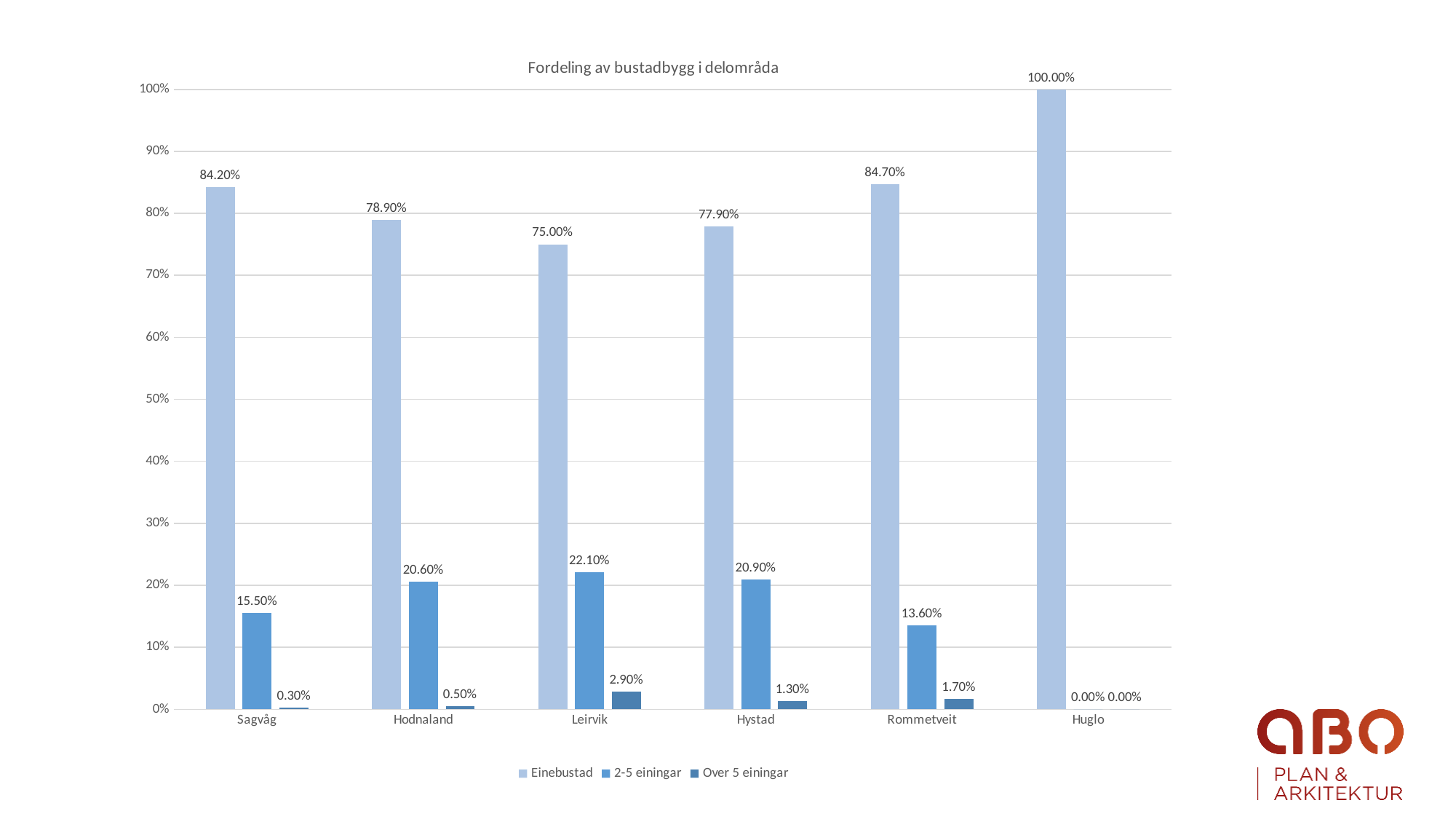
Which category has the highest Over 5 einingar value? Leirvik Which category has the highest Einebustad value? Huglo How many categories are shown on the x axis? 6 What is the title of the chart? Fordeling av bustadbygg i delområda Which category has the lowest Einebustad value? Leirvik What is the Einebustad value for Sagvåg? 84.20% What is the Over 5 einingar value for Rommetveit? 1.70% What is the 2-5 einingar value for Leirvik? 22.10% How many series does the legend list? 3 What kind of chart is shown on the slide? Bar chart Which is larger, the 2-5 einingar value for Hystad or for Hodnaland? Hystad What is the difference between the Einebustad values for Rommetveit and Hodnaland? 5.80%